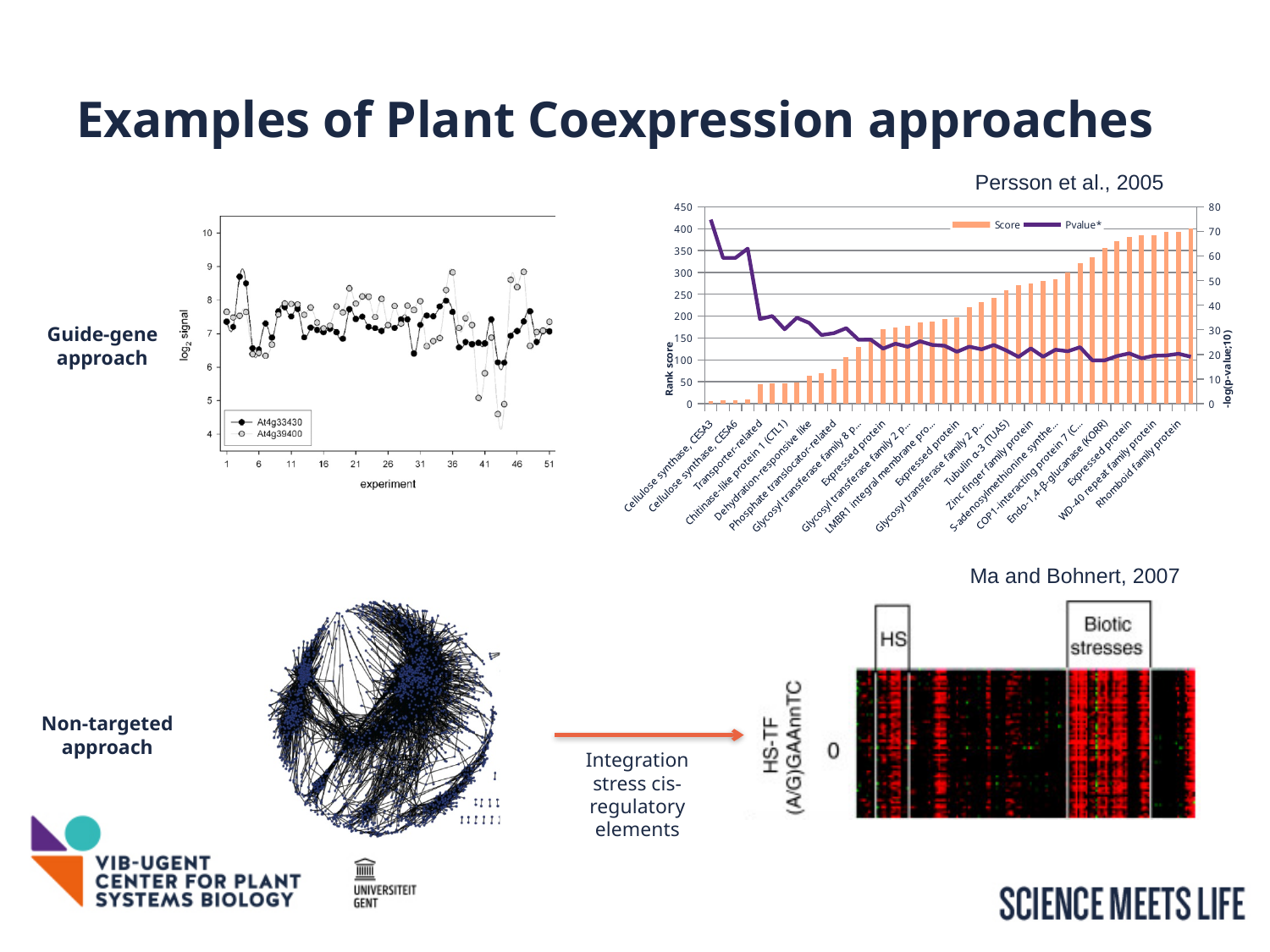
In the Persson et al., 2005 chart at the top right, how many series does the legend list? 2 In the Persson et al., 2005 chart at the top right, which category has the lowest Score bar? Cellulose synthase, CESA3 What kind of chart is the Guide-gene approach chart on the left of the slide? line chart In the Persson et al., 2005 chart at the top right, is the Score for Rhomboid family protein greater or less than 350? greater In the Persson et al., 2005 chart at the top right, does the Pvalue* line rise or fall overall from left to right? fall In the Persson et al., 2005 chart at the top right, is the Score for Cellulose synthase, CESA3 greater or less than 50? less In the Persson et al., 2005 chart at the top right, what are the two series named in the legend? Score and Pvalue* In the Guide-gene approach chart on the left, how many series does the legend list? 2 In the Persson et al., 2005 chart at the top right, which has the larger Score: Tubulin α-3 (TUA5) or Transporter-related? Tubulin α-3 (TUA5) In the Guide-gene approach chart on the left, what is the label of the x axis? experiment In the Persson et al., 2005 chart at the top right, do the Score bars rise or fall from left to right along the x axis? rise